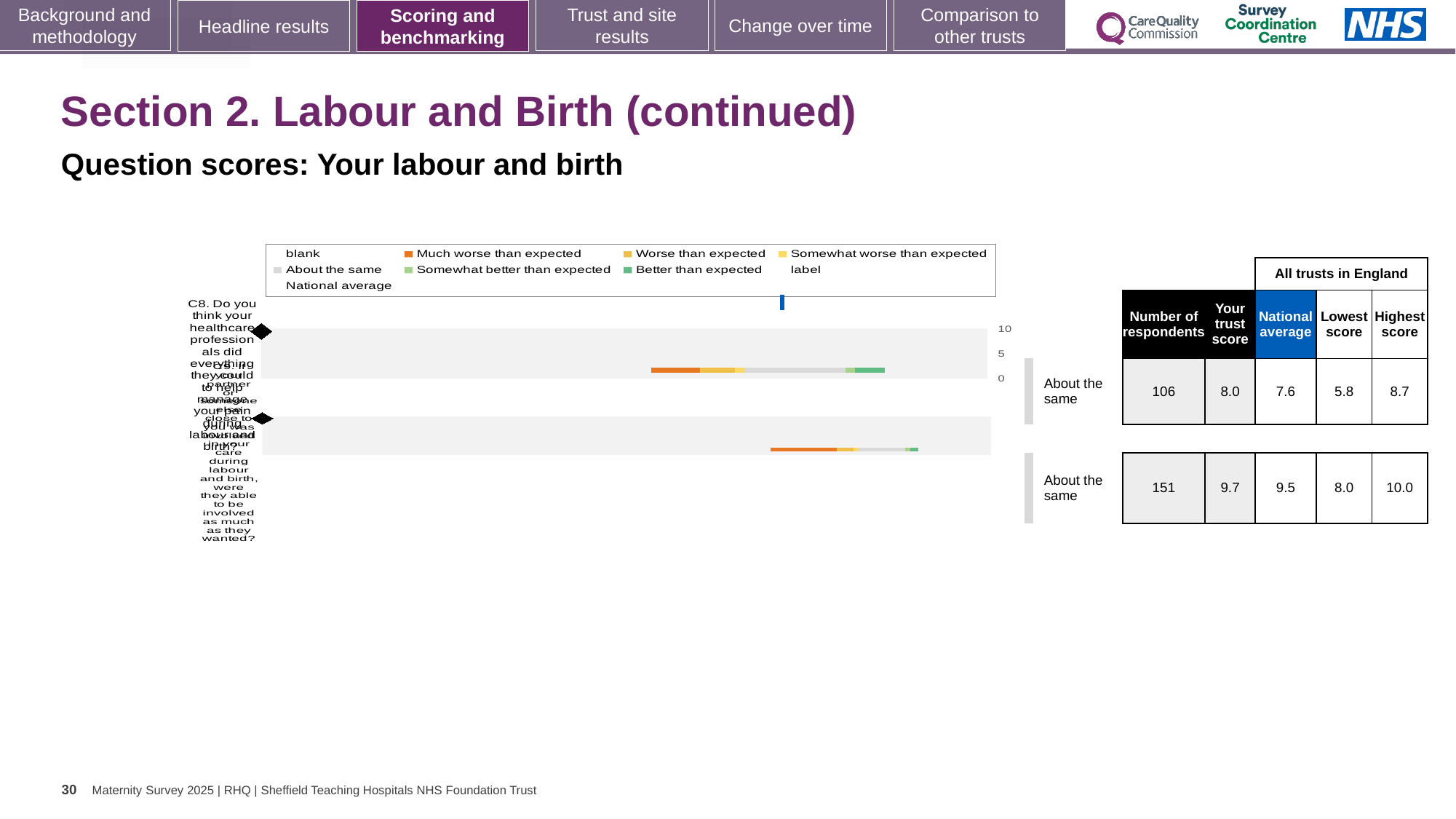
What is the difference between the trust score and the national average for the first (top) question row? 0.4 Which question row has the higher 'Your trust score', the first (top) or the second (bottom)? the second (bottom) In the chart legend, what colour represents 'Better than expected'? green What is the highest score among all trusts in England for the second (bottom) question row? 10.0 What is the number of respondents for the first (top) question row? 106 In the chart legend, what colour represents 'Much worse than expected'? orange How many question rows are plotted in the chart? 2 What is the lowest score among all trusts in England for the first (top) question row? 5.8 What is the national average for the second (bottom) question row? 9.5 What is the 'Your trust score' for the second (bottom) question row? 9.7 What kind of chart is shown on the slide? bar chart What is the 'Your trust score' for the first (top) question row? 8.0